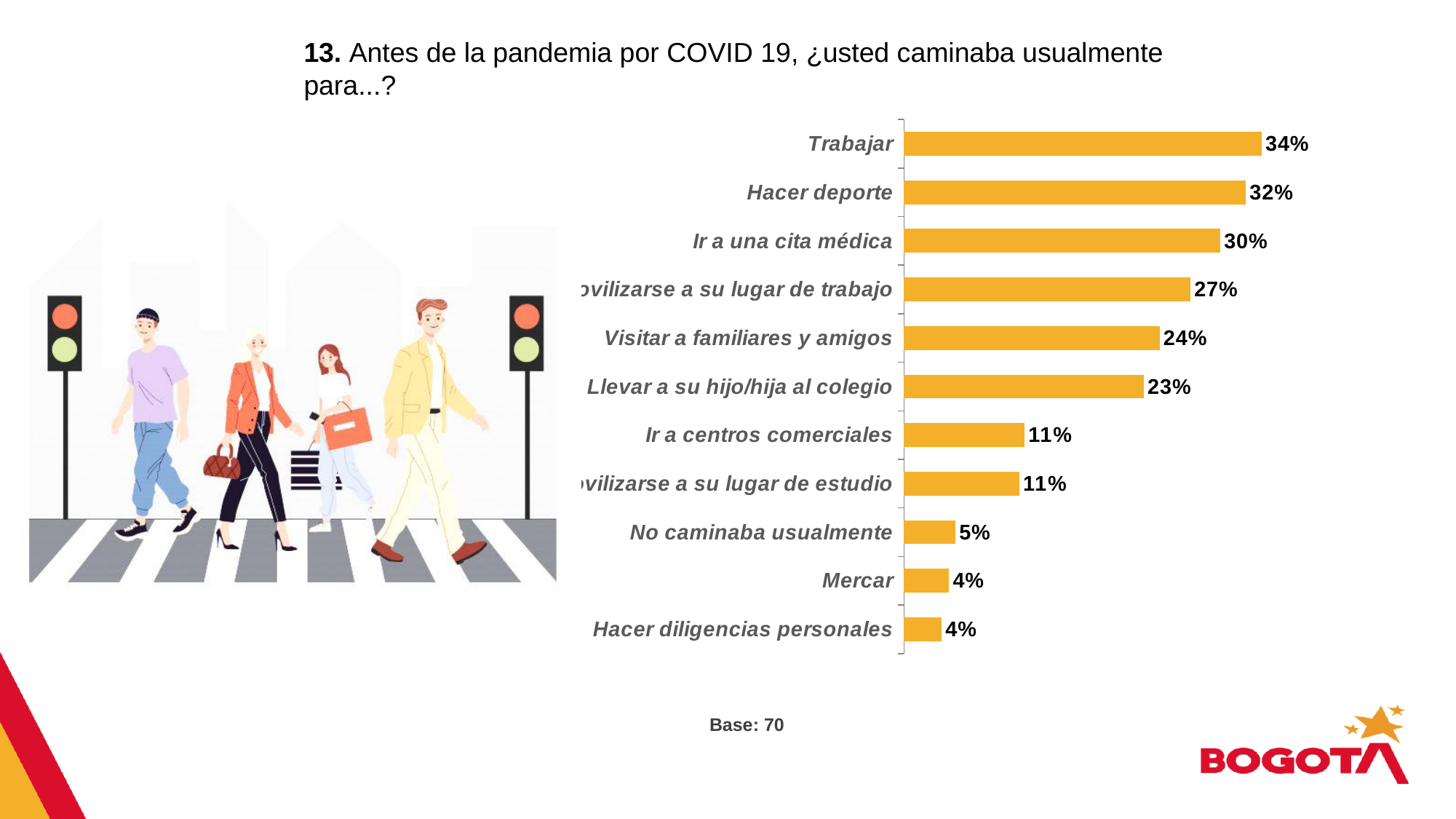
What is the difference in percentage points between 'Ir a una cita médica' and 'Mercar'? 26 percentage points What is the value for 'No caminaba usualmente'? 5% What is the difference in percentage points between 'Trabajar' and 'Hacer deporte'? 2 percentage points What percentage of respondents said they usually walked to 'Trabajar' before the pandemic? 34% What is the value shown for 'Ir a una cita médica'? 30% How many categories are shown in the chart? 11 What percentage is shown for 'Llevar a su hijo/hija al colegio'? 23% What base (number of respondents) is stated below the chart? Base: 70 What type of chart is shown on the slide? Bar chart What is the value shown for 'Hacer deporte'? 32% Which has a higher value, 'Visitar a familiares y amigos' or 'Ir a centros comerciales'? Visitar a familiares y amigos Which category has the highest value in the chart? Trabajar